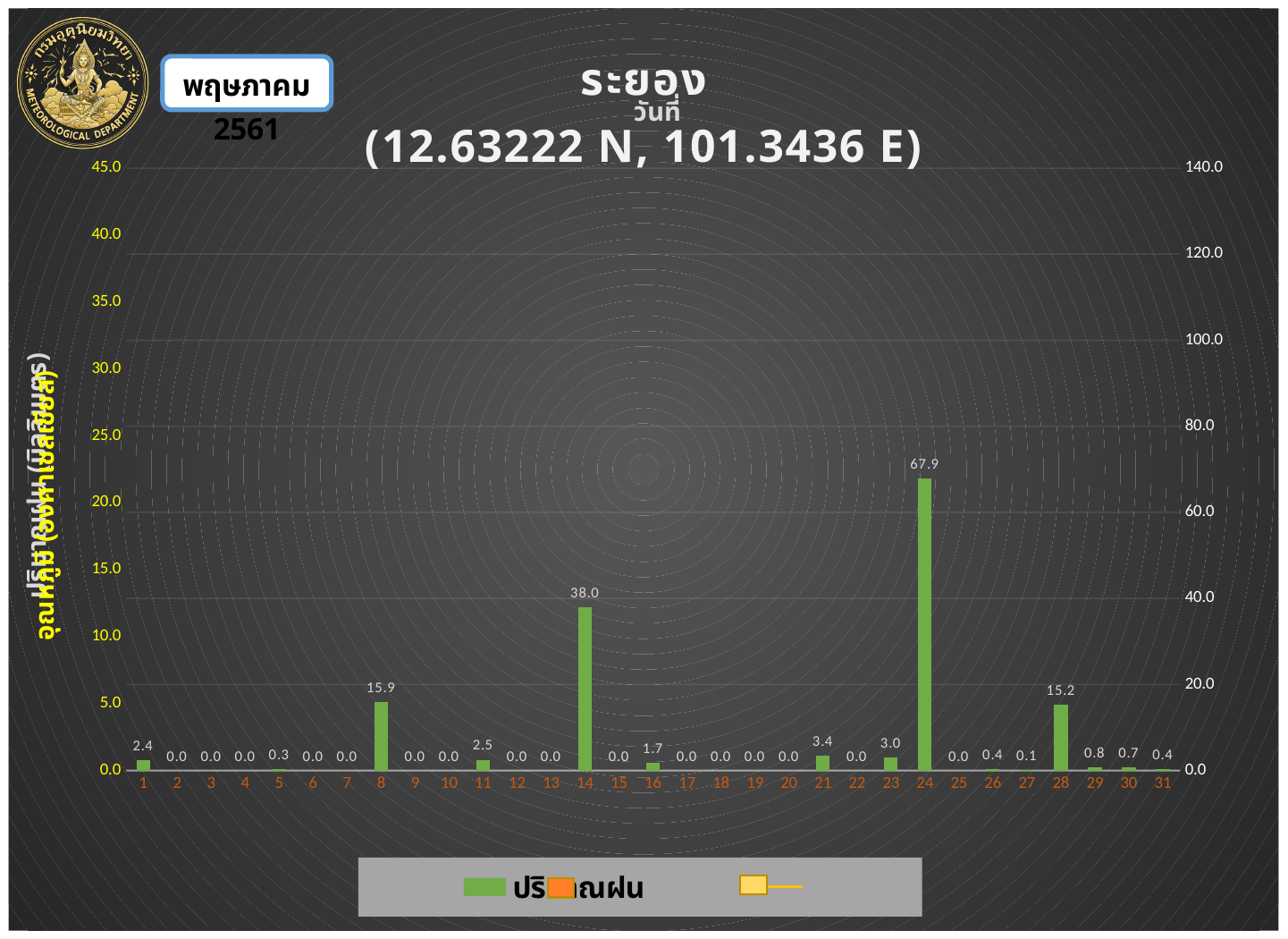
What is the rainfall value shown for day 14? 38.0 Which day has the highest rainfall value? 24 What is the rainfall value shown for day 28? 15.2 Which is larger, the rainfall value for day 21 or for day 23? day 21 What kind of chart is shown on the slide? bar chart What is the name of the station shown in the chart title? ระยอง What is the difference between the rainfall values for day 8 and day 28? 0.7 What is the rainfall value shown for day 1? 2.4 What is the rainfall value shown for day 24? 67.9 What is the rainfall value shown for day 8? 15.9 What is the difference between the rainfall values for day 24 and day 14? 29.9 How many days are shown on the x axis? 31